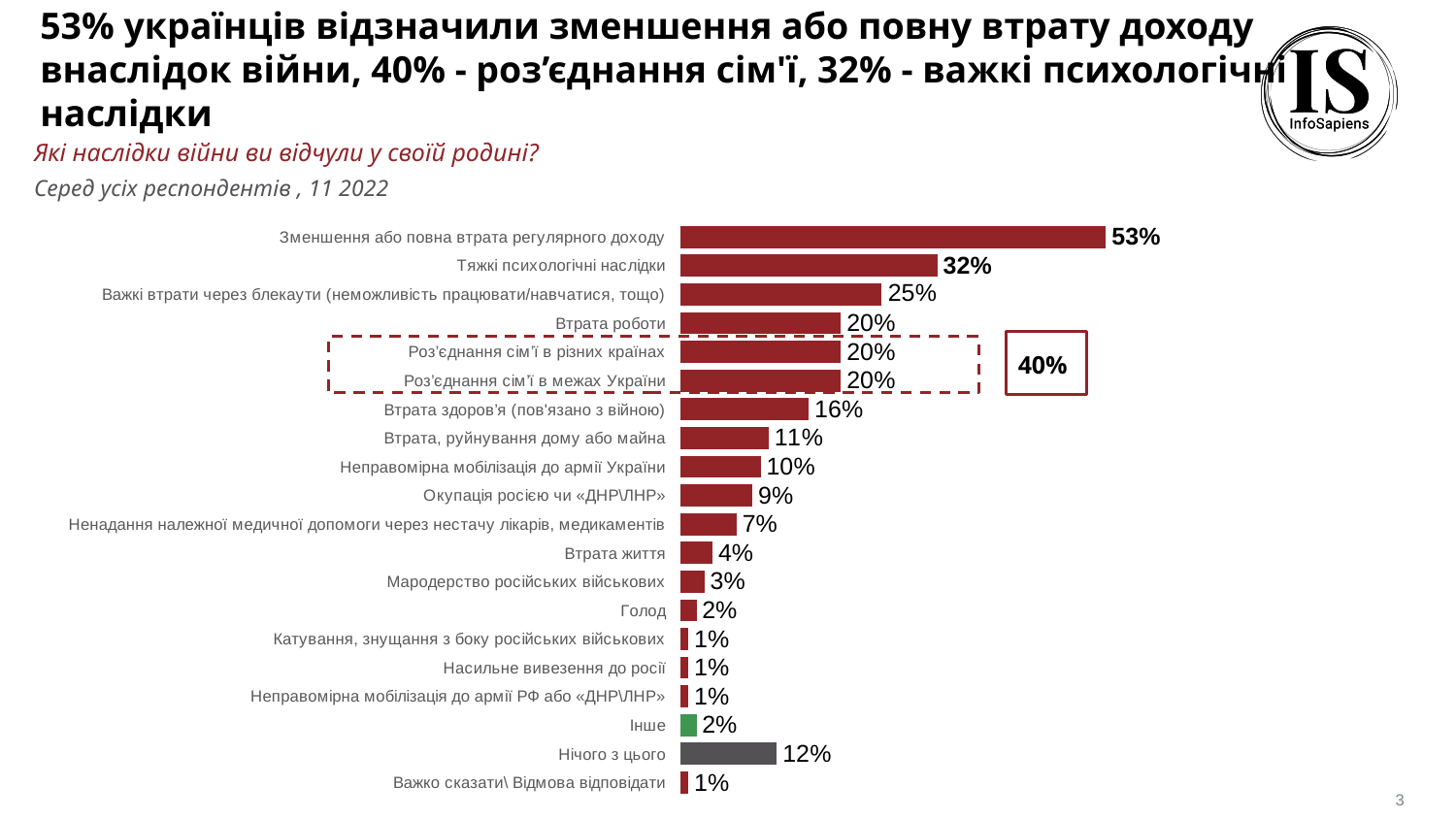
What value is shown in the box next to the dashed outline grouping the two "Роз'єднання сім'ї" bars? 40% What is the difference between "Зменшення або повна втрата регулярного доходу" and "Тяжкі психологічні наслідки"? 21% What is the value for "Тяжкі психологічні наслідки"? 32% What is the value for "Зменшення або повна втрата регулярного доходу"? 53% What is the value for "Голод"? 2% How many categories are plotted in the chart? 20 What is the difference between "Важкі втрати через блекаути" and "Втрата роботи"? 5% What is the value for "Нічого з цього"? 12% Which category has the highest value? Зменшення або повна втрата регулярного доходу Which is larger: "Втрата, руйнування дому або майна" or "Окупація росією чи «ДНР\ЛНР»"? Втрата, руйнування дому або майна What is the value for "Втрата здоров'я (пов'язано з війною)"? 16% What type of chart is shown on the slide? bar chart